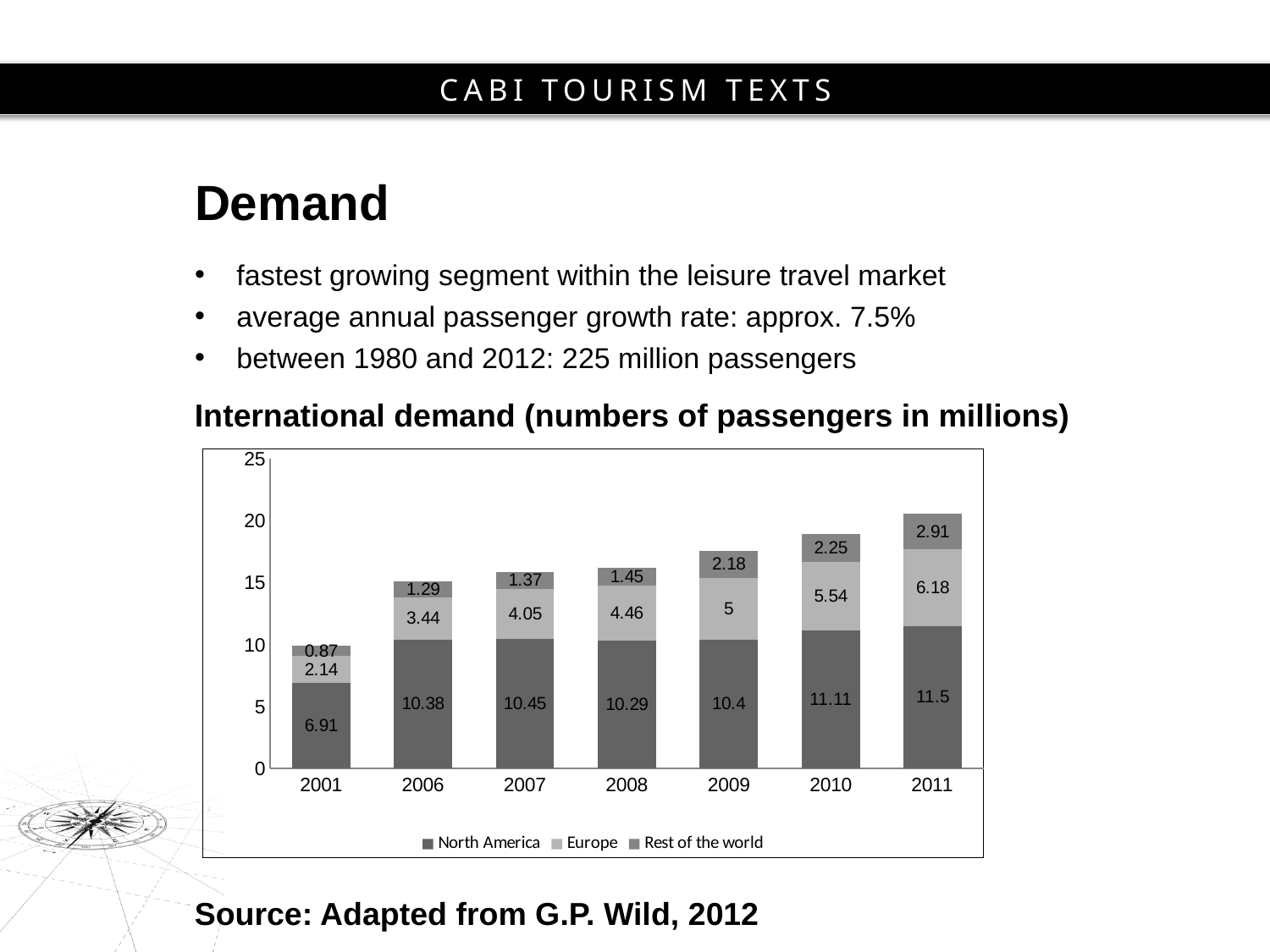
In which year is the Europe value highest? 2011 What is the value for Rest of the world in 2001? 0.87 What is the total of the stacked bar for 2001? 9.92 Which is larger, the North America value in 2007 or in 2008? 2007 What is the difference between the Europe values for 2011 and 2010? 0.64 What is the value for North America in 2011? 11.5 What is the value for Europe in 2009? 5 How many years are shown on the x axis? 7 What type of chart is shown on the slide? Stacked bar chart How many series does the legend list? 3 In which year is the North America value lowest? 2001 Do the Rest of the world values rise or fall from 2001 to 2011? Rise